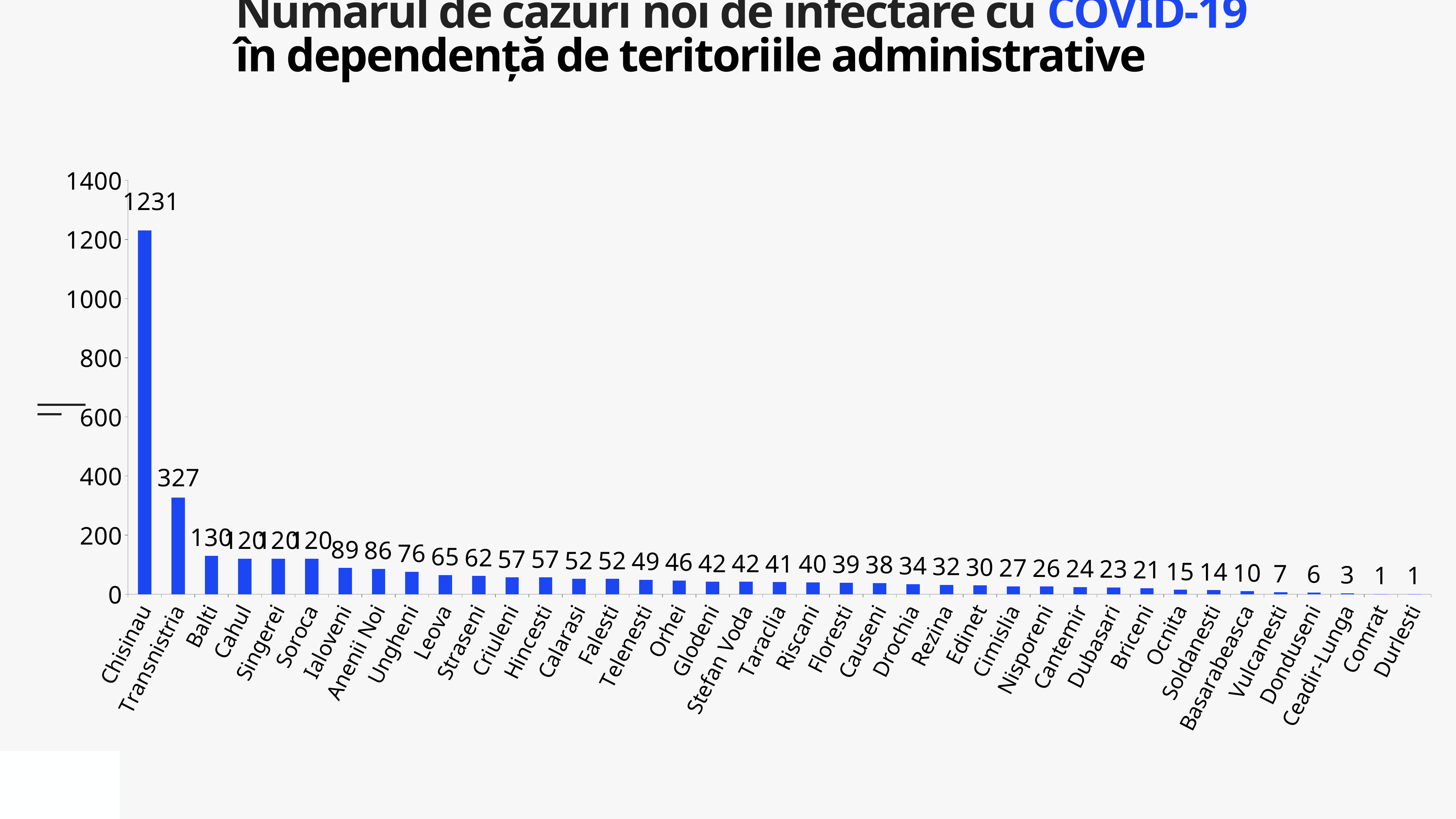
Is the value for Transnistria greater or less than 400? less What is the value for Transnistria? 327 How many territories are shown on the x axis? 39 What is the value for Orhei? 46 Which is larger, the value for Ungheni or the value for Leova? Ungheni Do the values rise or fall from left to right along the x axis? fall What is the value for Chisinau? 1231 What is the value for Ocnita? 15 What is the value for Ialoveni? 89 What is the difference between the values for Chisinau and Transnistria? 904 Which territory has the highest number of new COVID-19 cases? Chisinau What type of chart is shown on the slide? bar chart